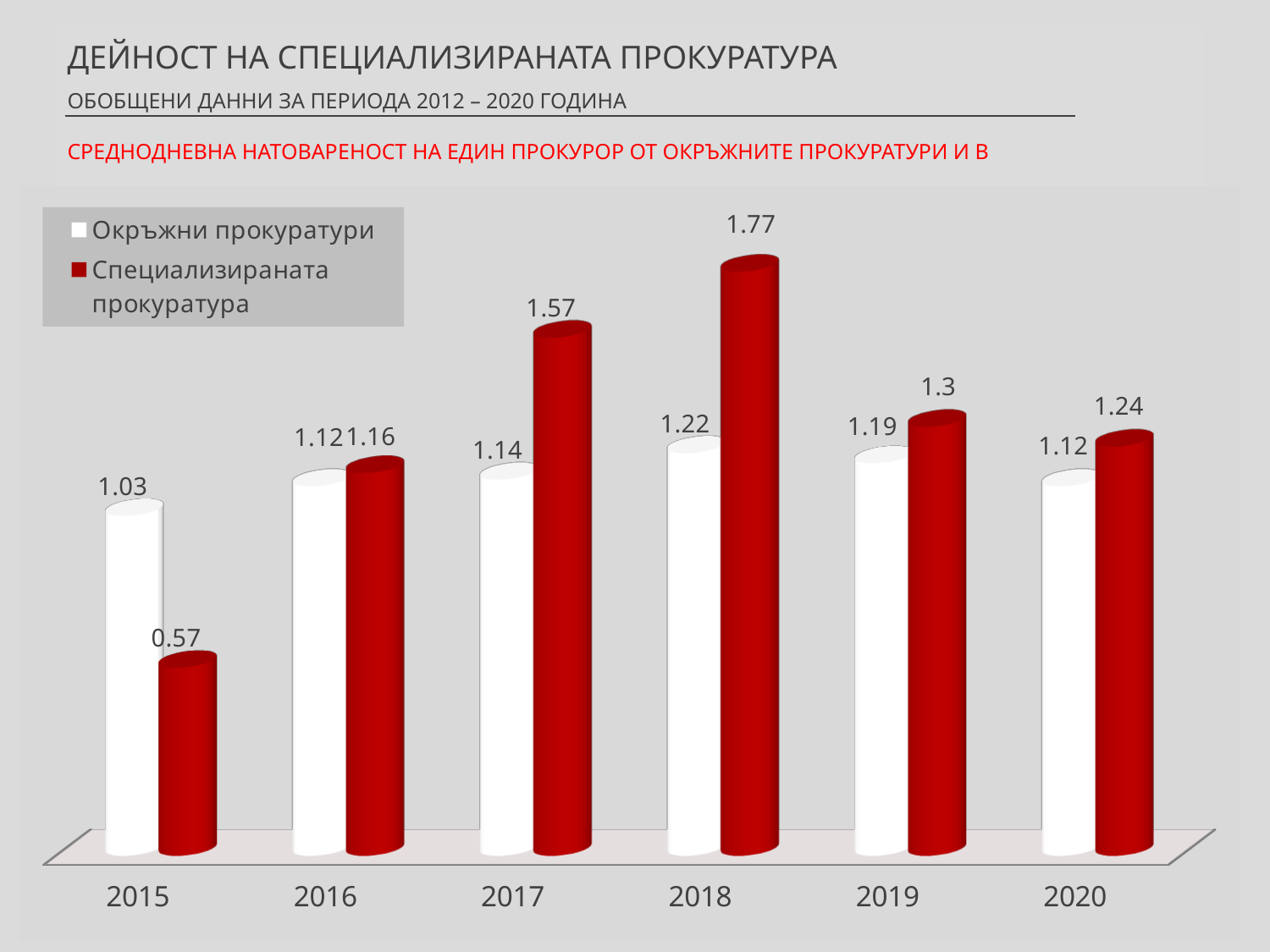
In which year is the value for Специализираната прокуратура highest? 2018 What is the difference between Специализираната прокуратура and Окръжни прокуратури in 2017? 0.43 What is the value for Окръжни прокуратури in 2015? 1.03 What is the value for Специализираната прокуратура in 2015? 0.57 In which year is the value for Окръжни прокуратури highest? 2018 Which series has the larger value in 2015, Окръжни прокуратури or Специализираната прокуратура? Окръжни прокуратури What is the value for Окръжни прокуратури in 2019? 1.19 How many series does the legend list? 2 How many years are shown on the x axis? 6 What is the value for Специализираната прокуратура in 2018? 1.77 What kind of chart is shown on the slide? Bar chart In which year is the value for Специализираната прокуратура lowest? 2015